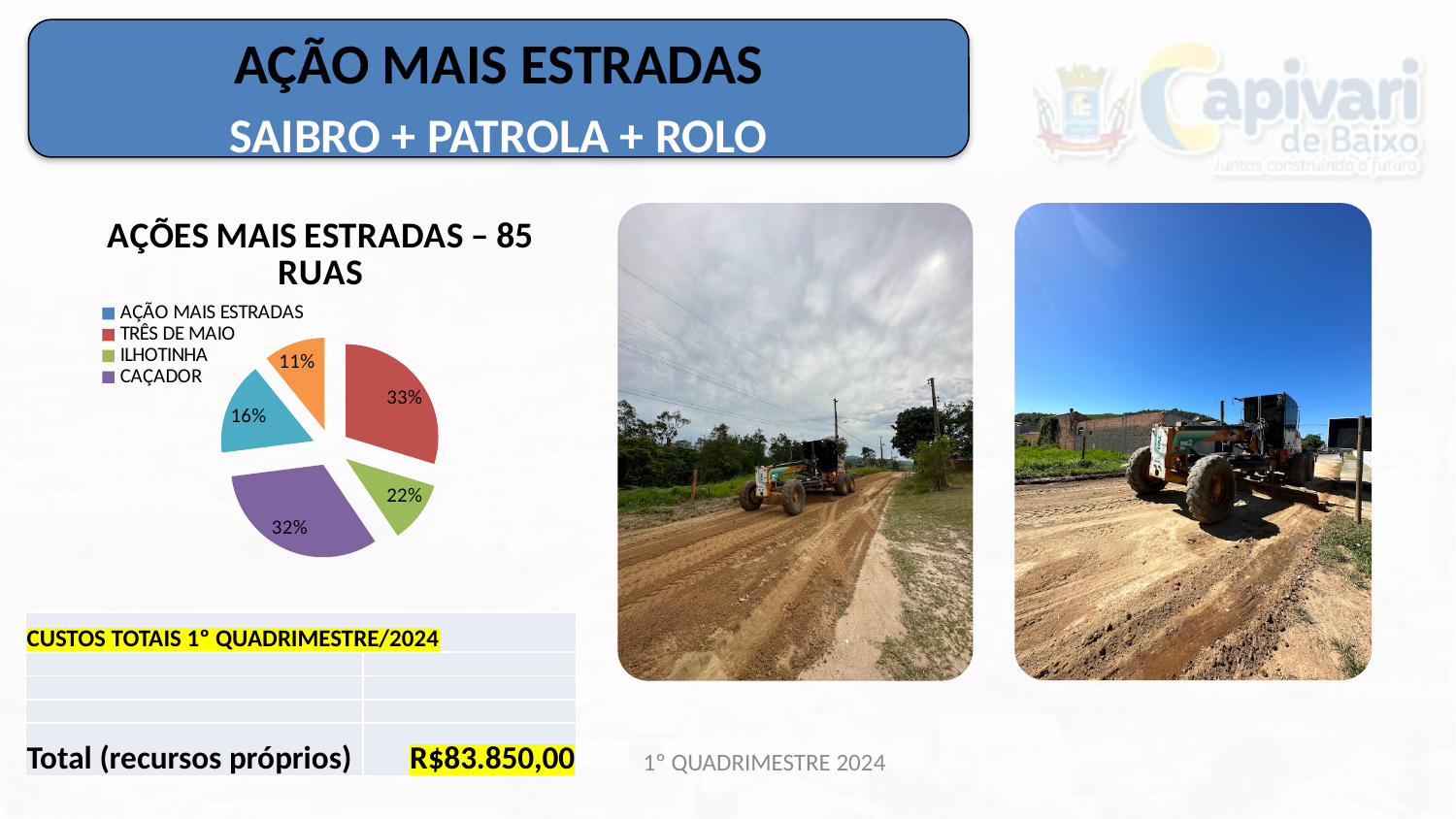
What is the smallest percentage shown on any slice of the pie chart? 11% What is the difference in percentage points between the ILHOTINHA slice and the CAÇADOR slice? 10 percentage points Which slice is larger in the pie chart, ILHOTINHA or CAÇADOR? CAÇADOR Which named legend category has the largest slice in the pie chart? TRÊS DE MAIO What percentage does the CAÇADOR slice show in the pie chart? 32% What percentage does the TRÊS DE MAIO slice show in the pie chart? 33% What percentage is shown on the orange slice of the pie chart? 11% How many entries are listed in the pie chart's legend? 4 What is the title of the pie chart? AÇÕES MAIS ESTRADAS – 85 RUAS How many slices does the pie chart have? 5 What percentage does the ILHOTINHA slice show in the pie chart? 22% What type of chart is shown on the slide? Pie chart